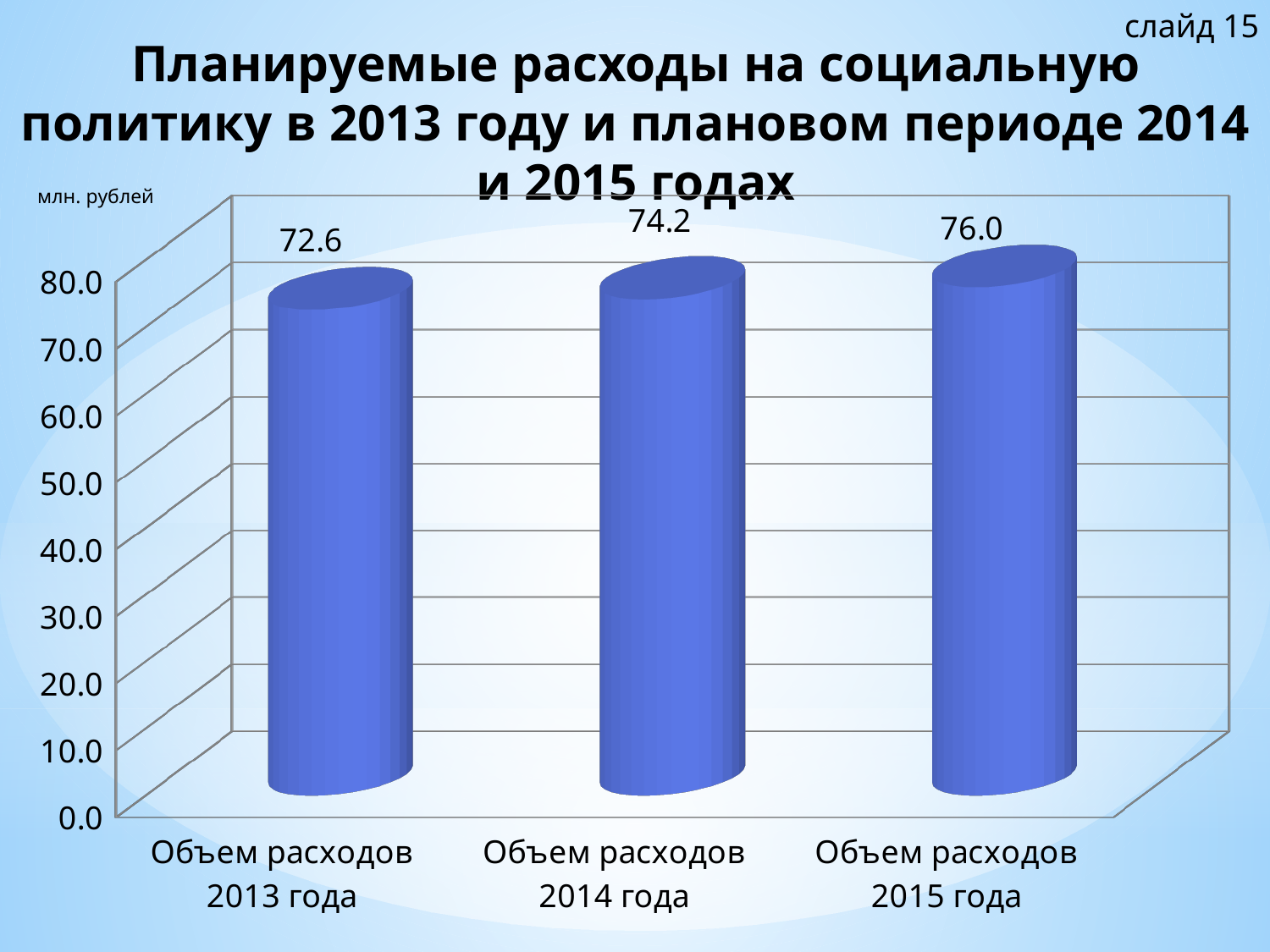
What is the difference between the values for Объем расходов 2015 года and Объем расходов 2013 года? 3.4 What is the value for Объем расходов 2014 года? 74.2 What is the value for Объем расходов 2013 года? 72.6 Which category has the lowest value? Объем расходов 2013 года What is the value for Объем расходов 2015 года? 76.0 Do the values rise or fall from 2013 to 2015? rise How many categories are shown in the chart? 3 What kind of chart is shown on the slide? bar chart What is the difference between the values for Объем расходов 2014 года and Объем расходов 2013 года? 1.6 Which is larger, the value for Объем расходов 2014 года or Объем расходов 2015 года? Объем расходов 2015 года Is the value for Объем расходов 2013 года greater or less than 70.0? greater Which category has the highest value? Объем расходов 2015 года